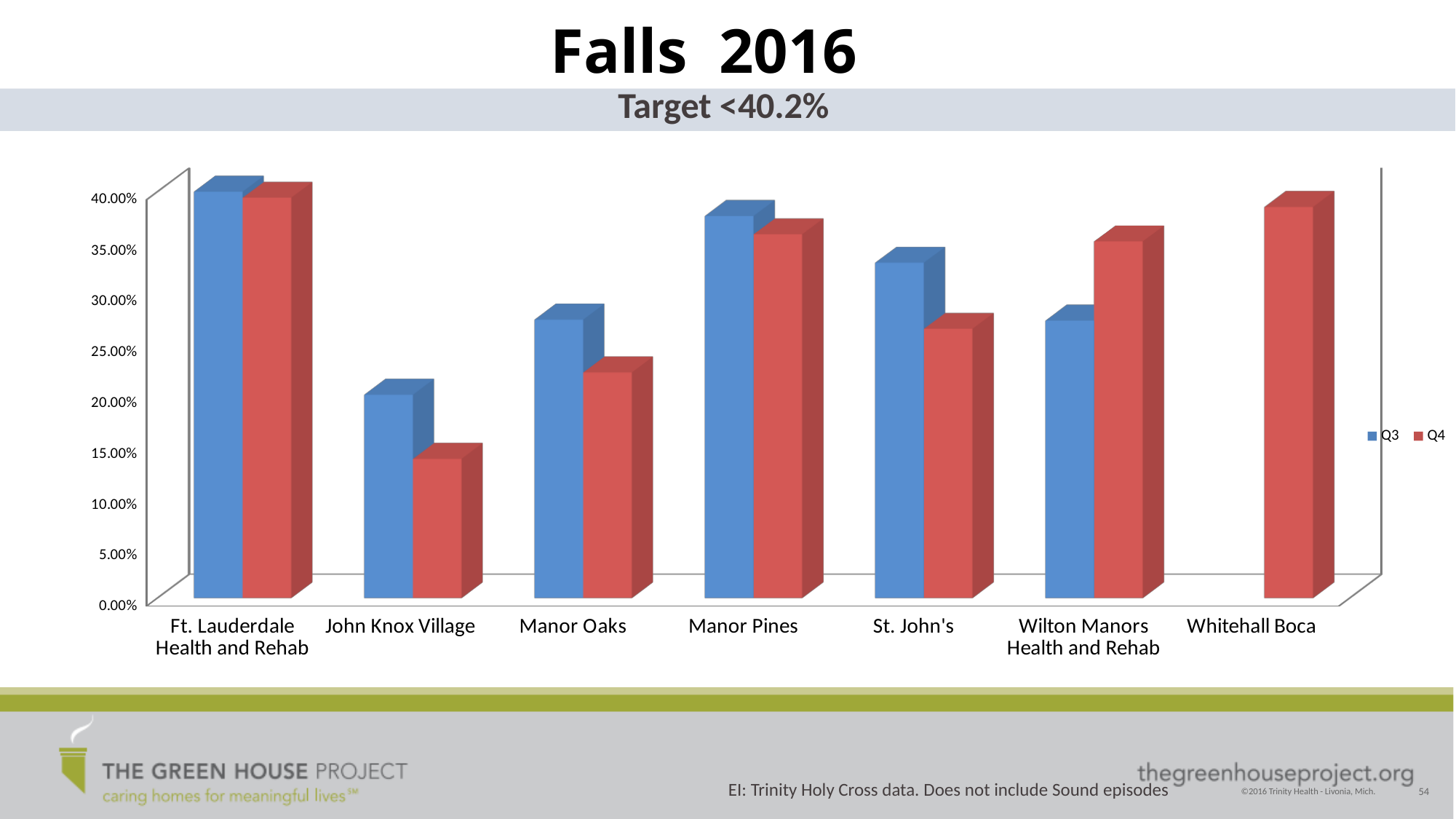
What target value is stated below the chart title? <40.2% Which facility has the lowest Q3 value? John Knox Village For John Knox Village, which is larger, the Q3 or the Q4 value? Q3 What kind of chart is shown on the slide? bar chart How many facilities are shown on the x axis of the chart? 7 Is the Q4 value for John Knox Village greater or less than 20.00%? less Is the Q3 value for St. John's greater or less than 30.00%? greater For Wilton Manors Health and Rehab, which is larger, the Q3 or the Q4 value? Q4 Which facility has the highest Q3 value? Ft. Lauderdale Health and Rehab How many series does the legend list? 2 Which facility has the lowest Q4 value? John Knox Village Which facility has only a Q4 bar and no Q3 bar? Whitehall Boca